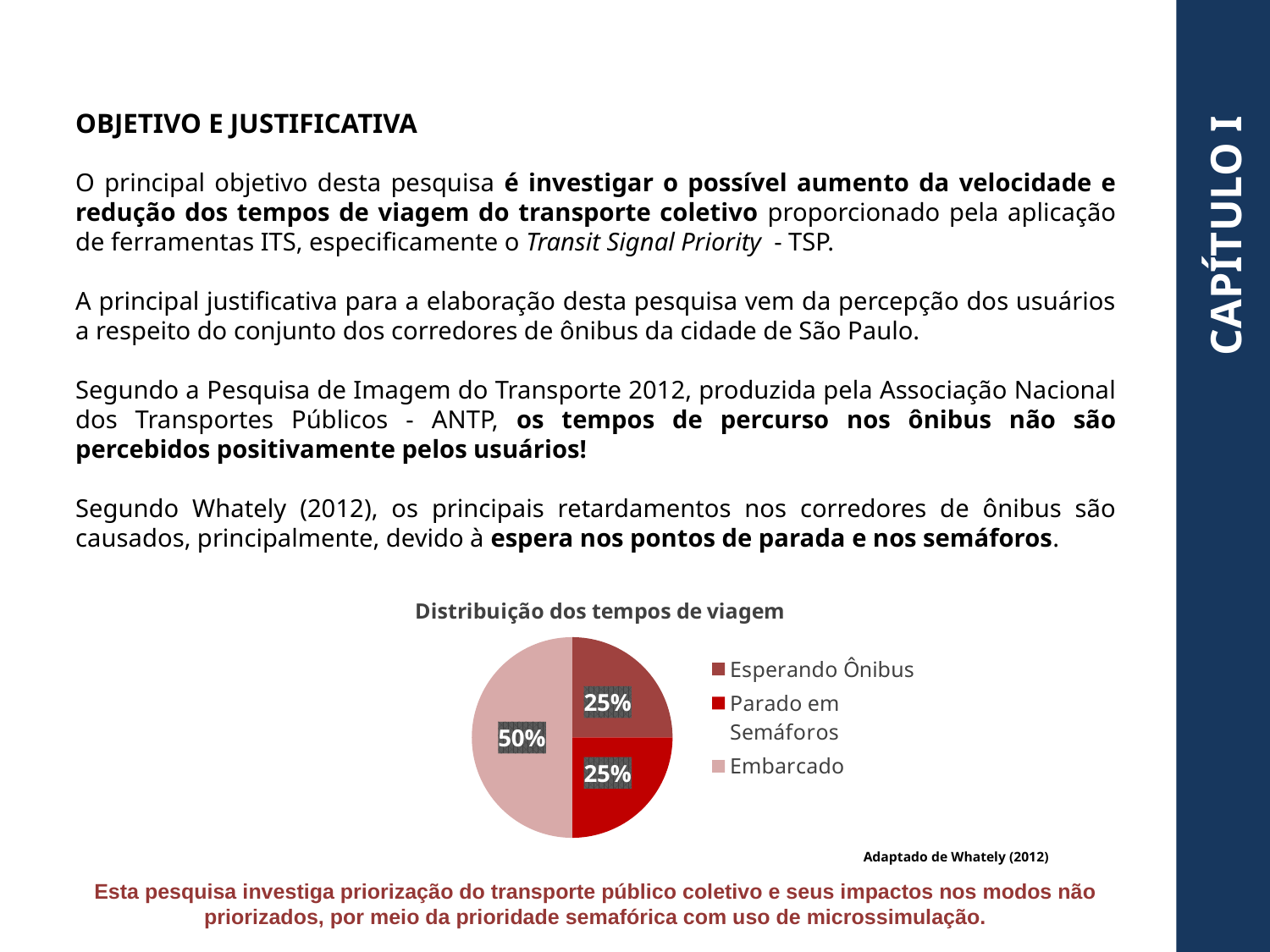
Which is larger in the pie chart: 'Embarcado' or 'Esperando Ônibus'? Embarcado What kind of chart is shown on the slide? Pie chart What is the difference between the 'Embarcado' share and the 'Parado em Semáforos' share? 25% Which legend entry is shown in the lightest (pink) colour in the pie chart? Embarcado What percentage is shown for 'Esperando Ônibus' in the pie chart? 25% What percentage is shown for 'Parado em Semáforos' in the pie chart? 25% How many slices does the pie chart have? 3 Which category has the largest slice in the pie chart? Embarcado What is the title of the chart on the slide? Distribuição dos tempos de viagem What share of travel time does the 'Embarcado' slice represent in the pie chart? 50% Do 'Esperando Ônibus' and 'Parado em Semáforos' have the same share in the pie chart? Yes How many entries does the legend of the pie chart list? 3